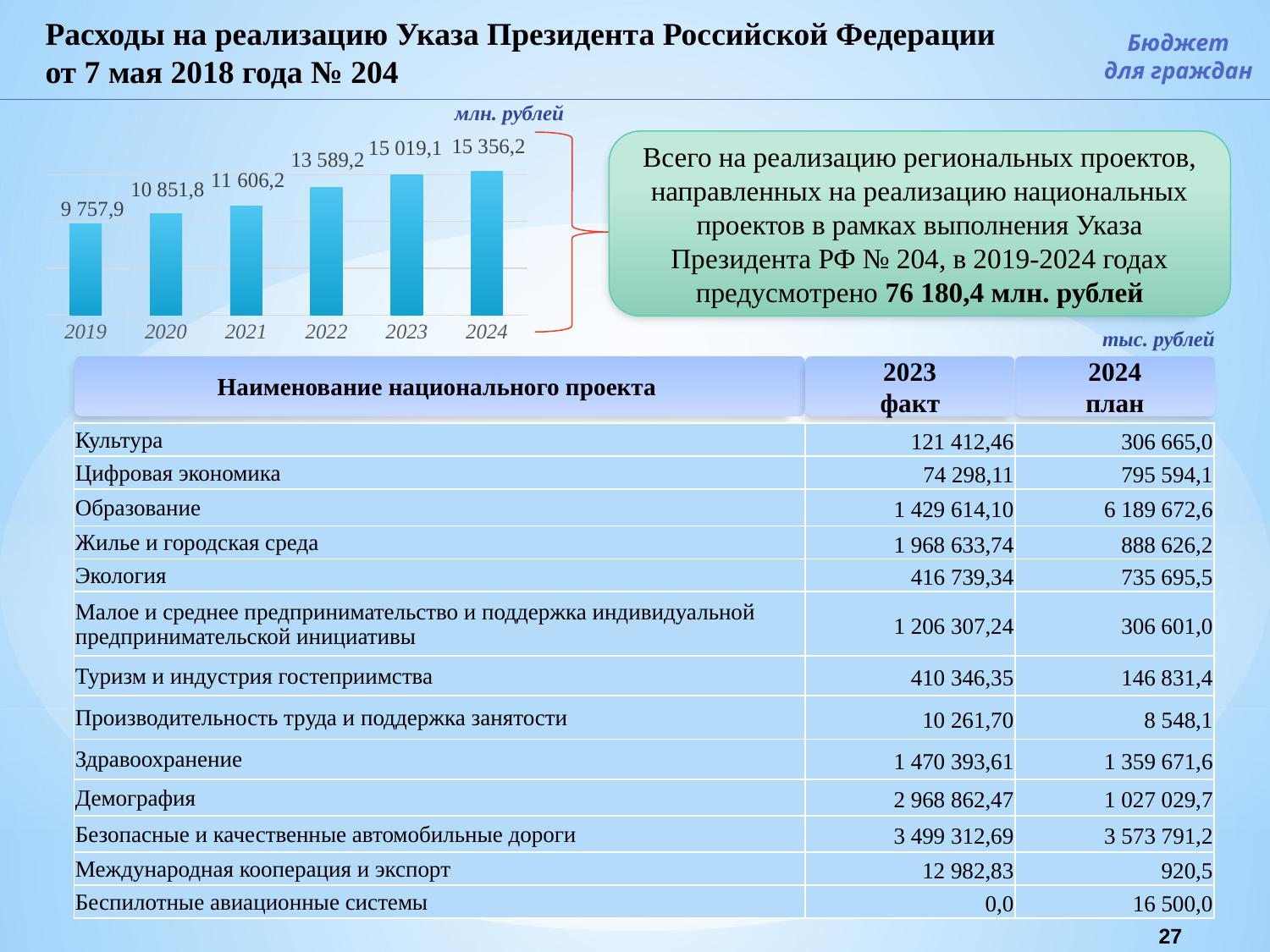
What is the value for 2024 on the bar chart? 15 356,2 How many years are shown on the bar chart? 6 What is the difference between the values for 2023 and 2022 on the bar chart? 1 429,9 What is the value for 2022 on the bar chart? 13 589,2 What unit is indicated above the bar chart? млн. рублей What is the difference between the values for 2024 and 2019 on the bar chart? 5 598,3 Which year has the lowest value on the bar chart? 2019 Which year has the highest value on the bar chart? 2024 Which is larger on the bar chart, the value for 2021 or the value for 2020? 2021 What type of chart is shown on the slide? bar chart What is the value for 2019 on the bar chart? 9 757,9 Do the values on the bar chart rise or fall from 2019 to 2024? rise